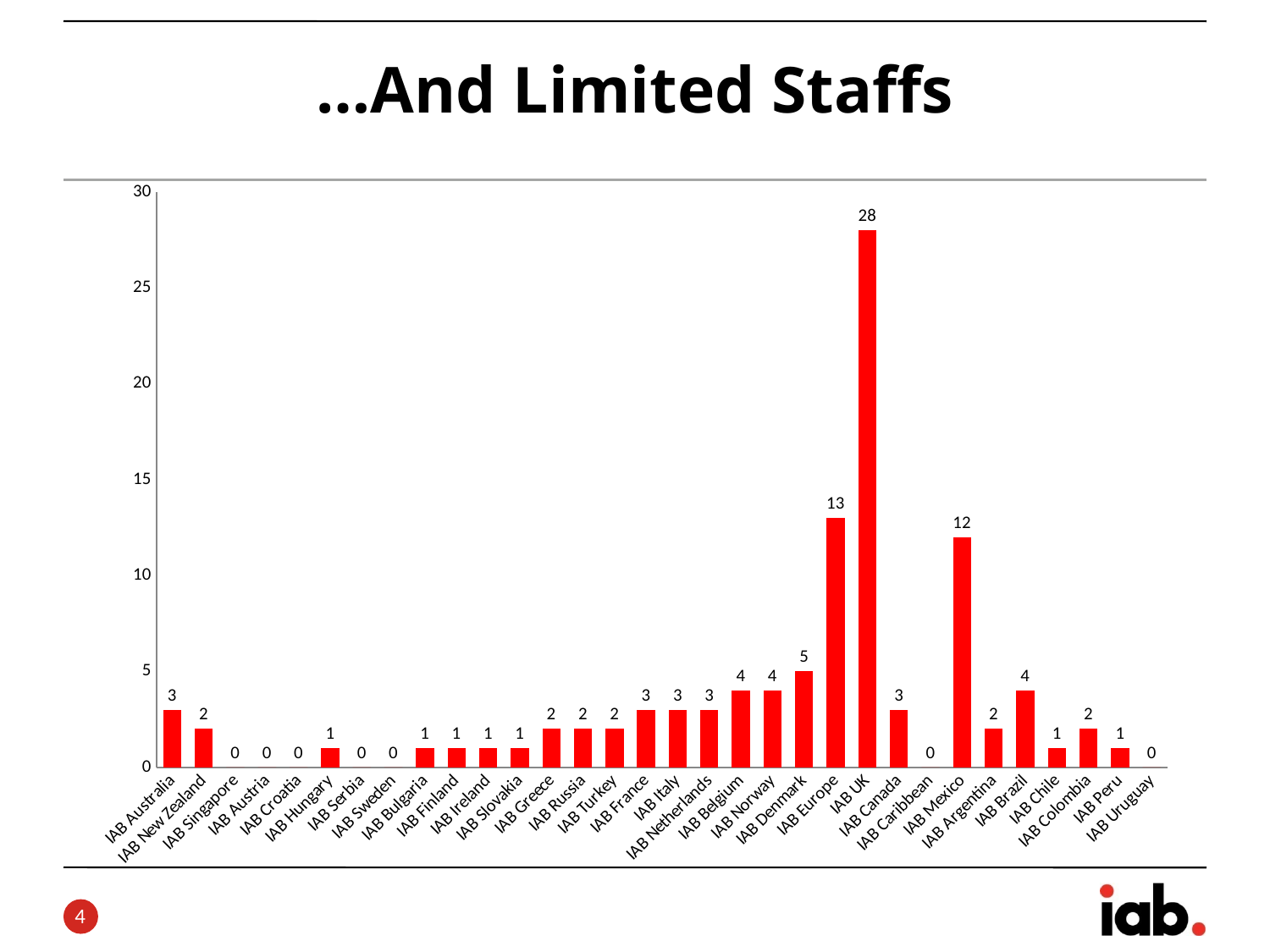
What is the difference between the values for IAB Mexico and IAB Brazil? 8 What is the value for IAB Mexico? 12 How many categories are shown on the x axis? 32 What kind of chart is shown on the slide? bar chart Which is larger, the value for IAB Europe or the value for IAB Mexico? IAB Europe Is the value for IAB UK greater or less than 25? greater What is the value for IAB Denmark? 5 What is the difference between the values for IAB UK and IAB Europe? 15 Which category has the highest value? IAB UK What is the value for IAB UK? 28 What is the title of the slide? …And Limited Staffs What is the value for IAB Europe? 13